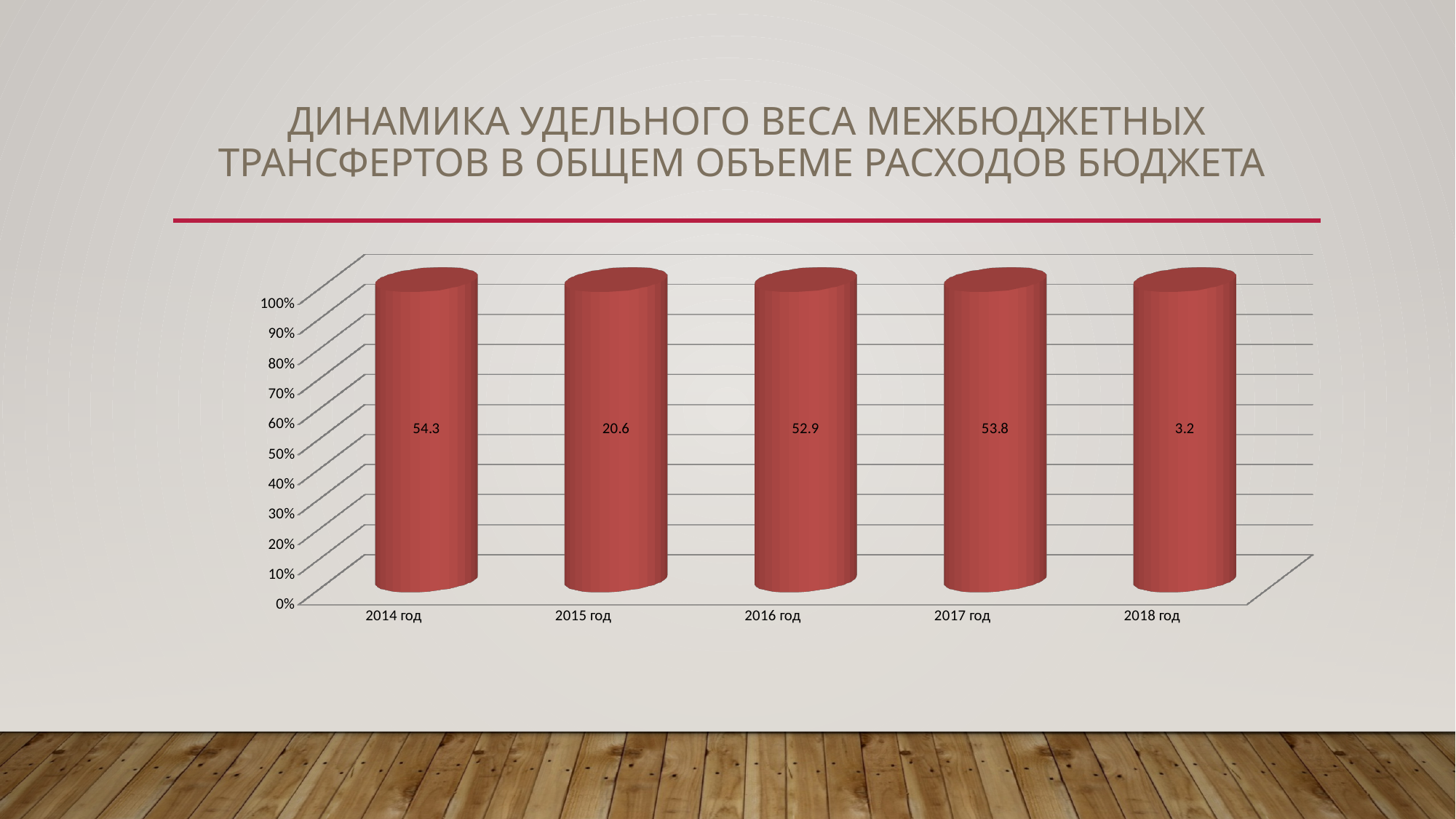
Which has the larger labelled value, 2015 год or 2017 год? 2017 год What is the data label shown for 2017 год? 53.8 What is the difference between the labelled values for 2014 год and 2016 год? 1.4 What kind of chart is shown on the slide? Bar chart What is the data label shown for 2015 год? 20.6 Which year has the lowest labelled value? 2018 год Which year has the highest labelled value? 2014 год What is the difference between the labelled values for 2017 год and 2015 год? 33.2 What is the data label shown for 2018 год? 3.2 What is the data label shown for 2014 год? 54.3 What is the data label shown for 2016 год? 52.9 How many years are shown on the x axis of the chart? 5